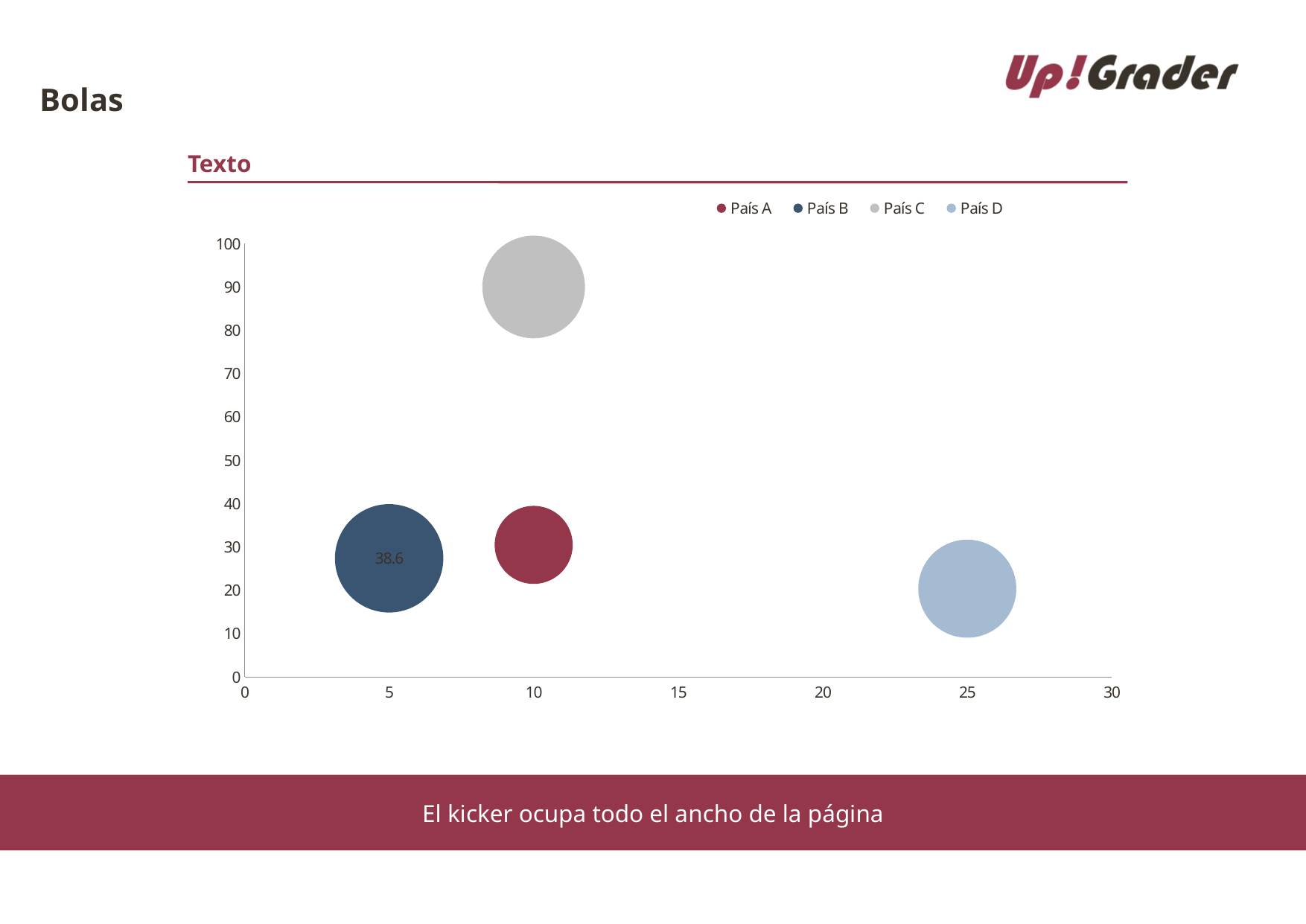
Is the horizontal-axis value for País D greater or less than 20? greater Which series has the highest position on the vertical axis? País C Which series has the lowest position on the vertical axis? País D Which series is positioned furthest to the right on the horizontal axis? País D What is the title shown above the chart? Texto How many bubbles are plotted on the chart? 4 What data label is printed on the País B bubble? 38.6 What kind of chart is shown on the slide? Bubble chart Is the vertical-axis value for País C greater or less than 80? greater How many series does the legend list? 4 Which series is positioned furthest to the left on the horizontal axis? País B Which is higher on the vertical axis, País A or País D? País A